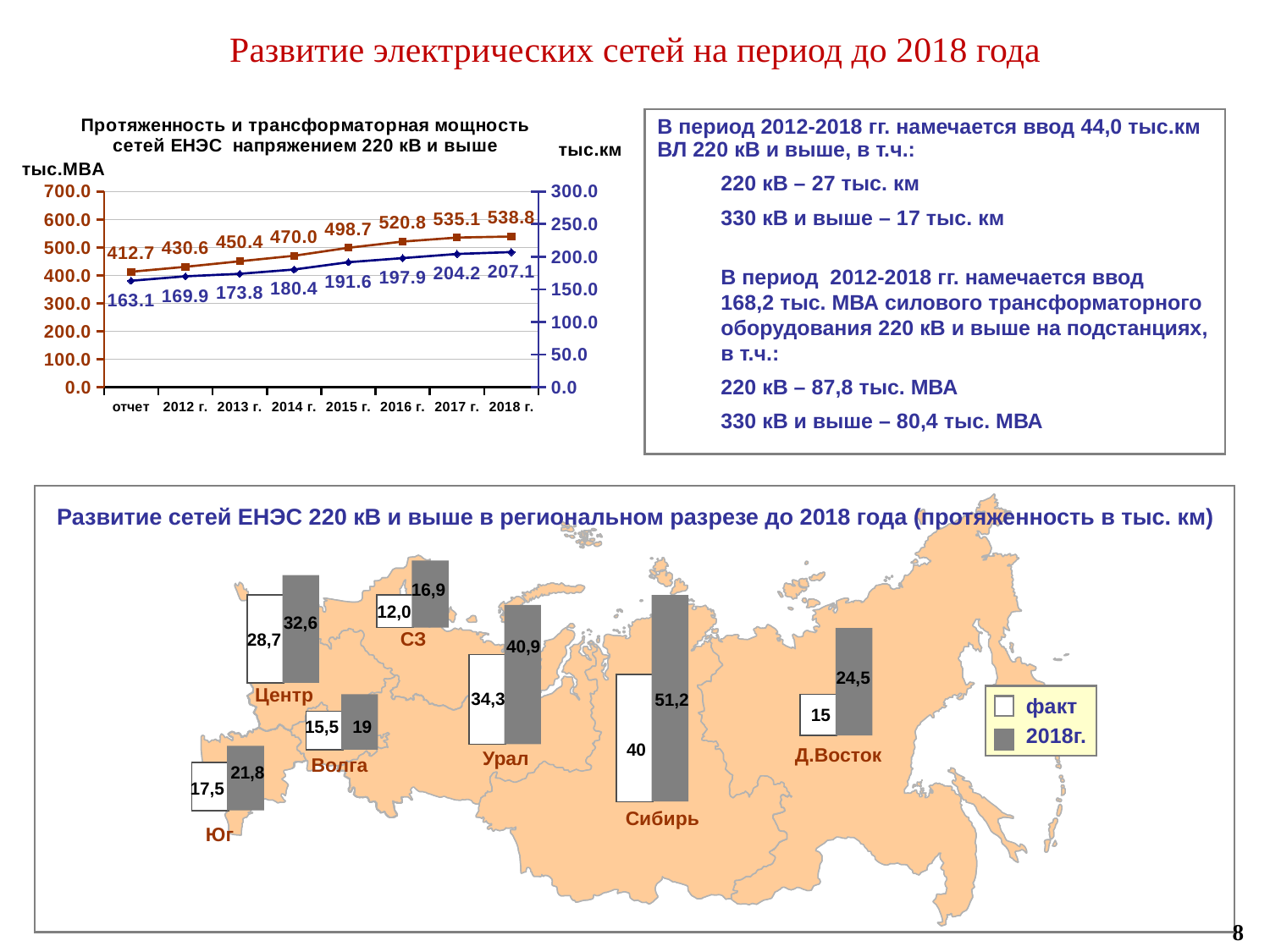
In the top-left line chart, what kind of chart is it? line chart In the bottom map chart, how many series does the legend list? 2 In the top-left line chart, what is the difference between the тыс.МВА values for 2018 г. and 2012 г.? 108.2 In the bottom map chart, which region has the highest 2018г. value? Сибирь In the bottom map chart 'Развитие сетей ЕНЭС 220 кВ и выше в региональном разрезе до 2018 года', what is the 2018г. value for Сибирь? 51,2 In the top-left line chart, how many points are plotted along the x axis for each series? 8 In the top-left line chart, do the тыс.км values rise or fall from 'отчет' to 2018 г.? rise In the top-left chart 'Протяженность и трансформаторная мощность сетей ЕНЭС напряжением 220 кВ и выше', what is the тыс.МВА value for 2018 г.? 538.8 In the bottom map chart, what is the факт value for Урал? 34,3 In the top-left line chart, what is the тыс.км value for 2015 г.? 191.6 In the bottom map chart, which region has the lowest факт value? СЗ In the top-left line chart, what is the тыс.МВА value for the 'отчет' point? 412.7